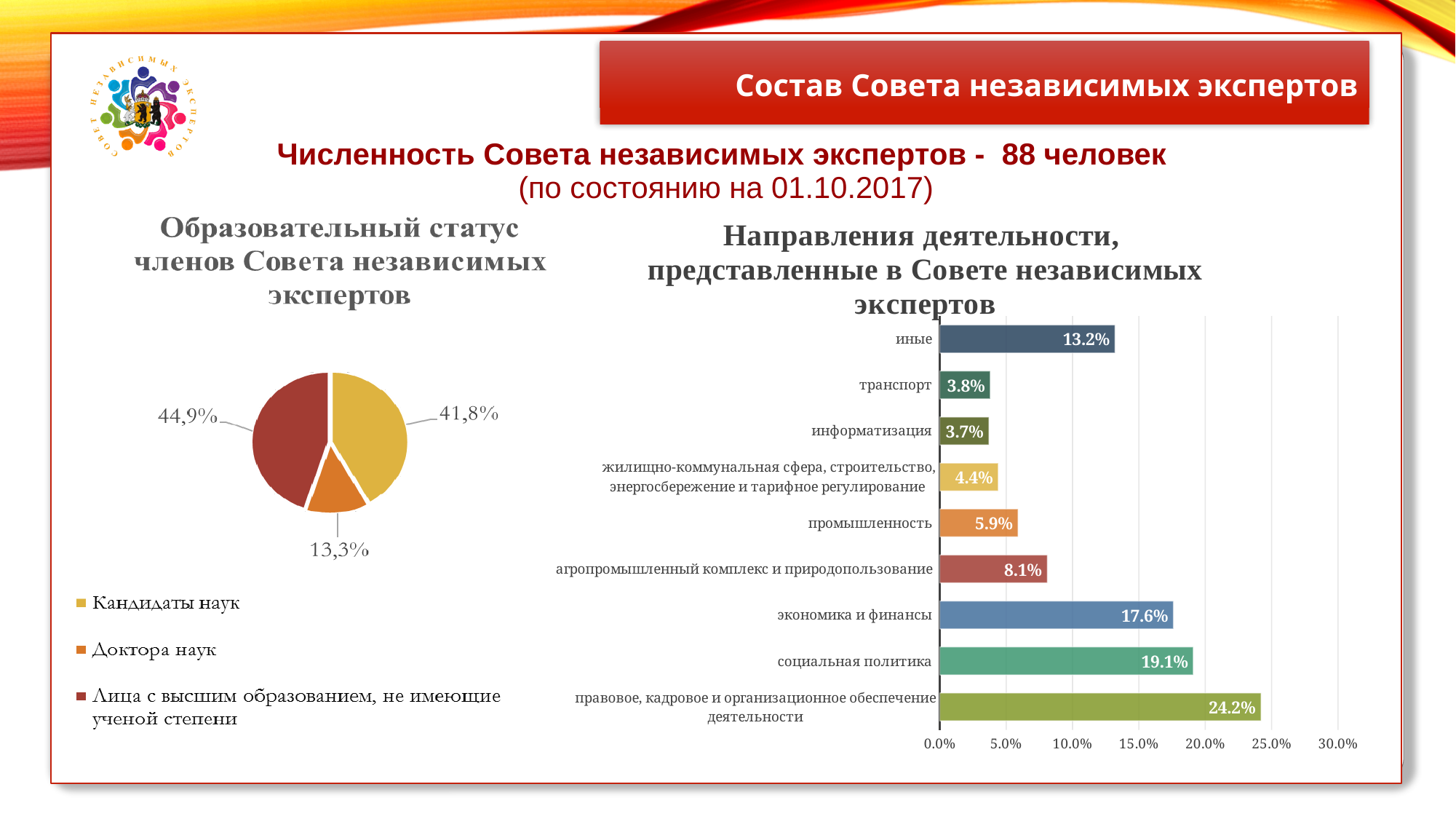
In the pie chart on the left, which category has the largest slice? Лица с высшим образованием, не имеющие ученой степени In the bar chart on the right, which category has the lowest value? информатизация In the pie chart on the left, what share is shown for Доктора наук? 13,3% In the bar chart on the right, what is the value for социальная политика? 19.1% In the bar chart on the right, which is larger: иные or агропромышленный комплекс и природопользование? иные In the bar chart on the right, which category has the highest value? правовое, кадровое и организационное обеспечение деятельности In the bar chart on the right, what is the difference between экономика и финансы and промышленность? 11.7% In the pie chart on the left, what share is shown for Кандидаты наук? 41,8% In the pie chart on the left, which category has the smallest slice? Доктора наук In the pie chart on the left, how many categories does the legend list? 3 In the bar chart on the right, what is the value for транспорт? 3.8% In the bar chart on the right, how many categories are plotted? 9